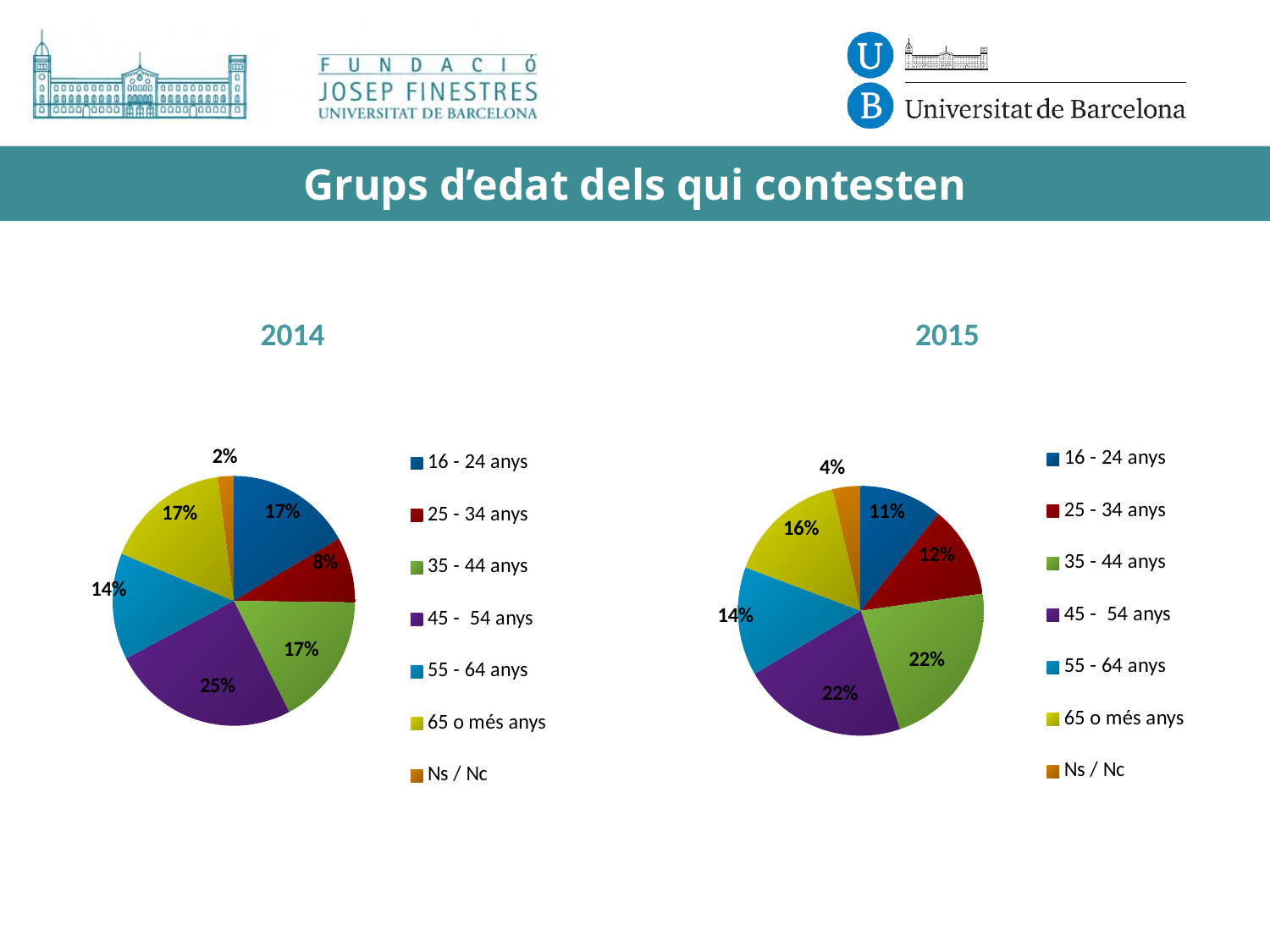
What is the title of the slide containing the two pie charts? Grups d'edat dels qui contesten What is the difference between the 45 - 54 anys share in 2014 and in 2015? 3% In the 2015 pie chart, what share of respondents are in the 16 - 24 anys group? 11% In the 2014 pie chart, what share of respondents are in the 45 - 54 anys group? 25% What type of chart is used to show the 2014 data? Pie chart In the 2014 pie chart, which category has the smallest share? Ns / Nc In the 2015 pie chart, what is the value for 65 o més anys? 16% How many categories does the legend of the 2015 pie chart list? 7 In the 2015 pie chart, which is larger: the share for 25 - 34 anys or the share for 55 - 64 anys? 55 - 64 anys In the 2014 pie chart, what is the value for 25 - 34 anys? 8% In the 2014 pie chart, which age group has the largest share? 45 - 54 anys In the 2015 pie chart, which category has the smallest share? Ns / Nc